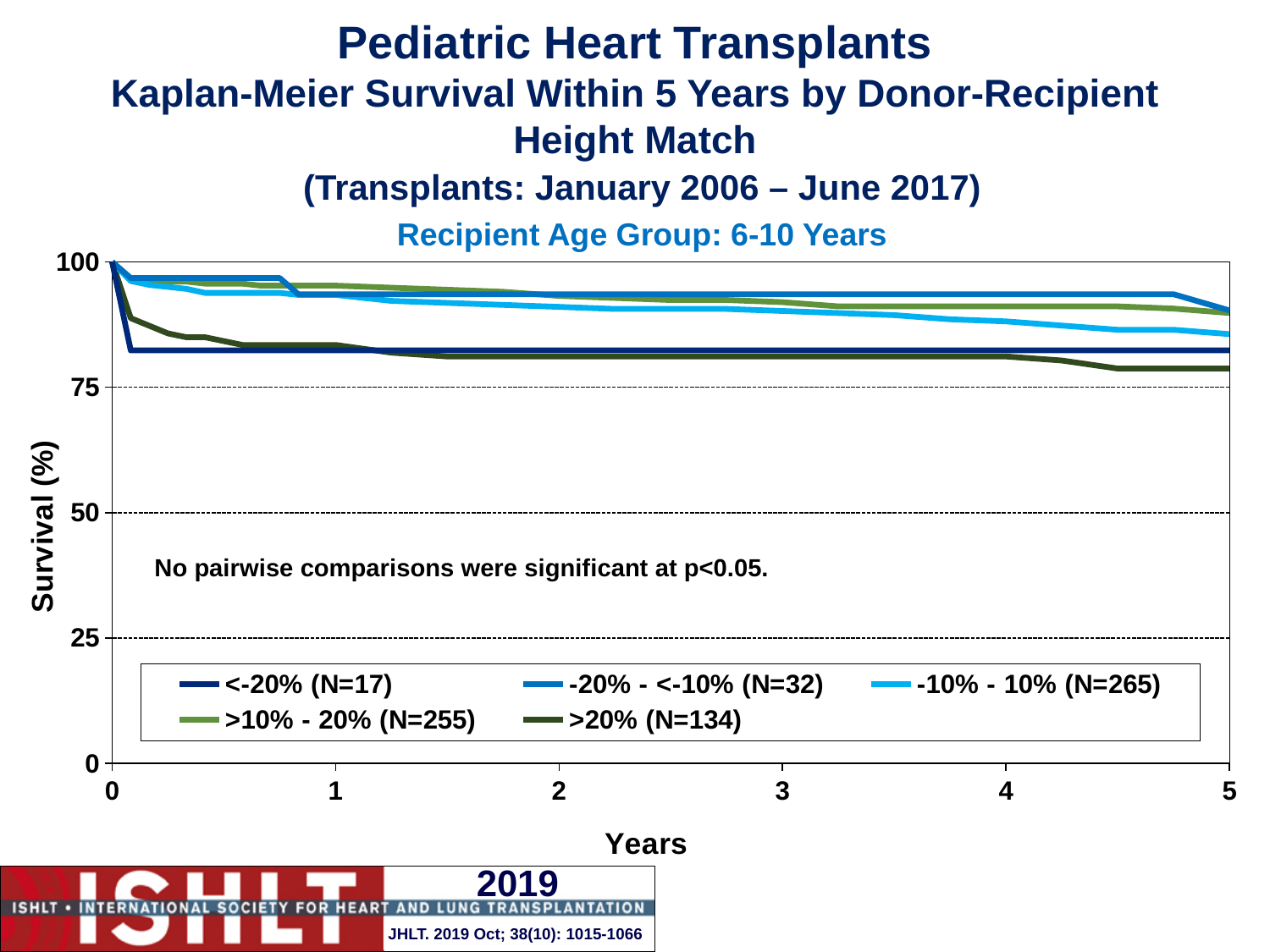
According to the legend, how many patients (N) are in the -10% - 10% group? 265 Do the survival curves rise or fall as the years increase along the x axis? Fall What kind of chart is shown on the slide? Line chart Is the survival value for the >10% - 20% (N=255) group at year 2 greater or less than 50? greater Is the survival value for the >20% (N=134) group at year 5 greater or less than 75? greater Is the survival value for the -20% - <-10% (N=32) group at year 4 greater or less than 75? greater At year 3, which group has higher survival: -10% - 10% (N=265) or >20% (N=134)? -10% - 10% (N=265) How many series does the legend list? 5 What recipient age group does the chart cover? 6-10 Years At year 5, which group has higher survival: -20% - <-10% (N=32) or <-20% (N=17)? -20% - <-10% (N=32) How many labelled tick marks are on the x axis (Years)? 6